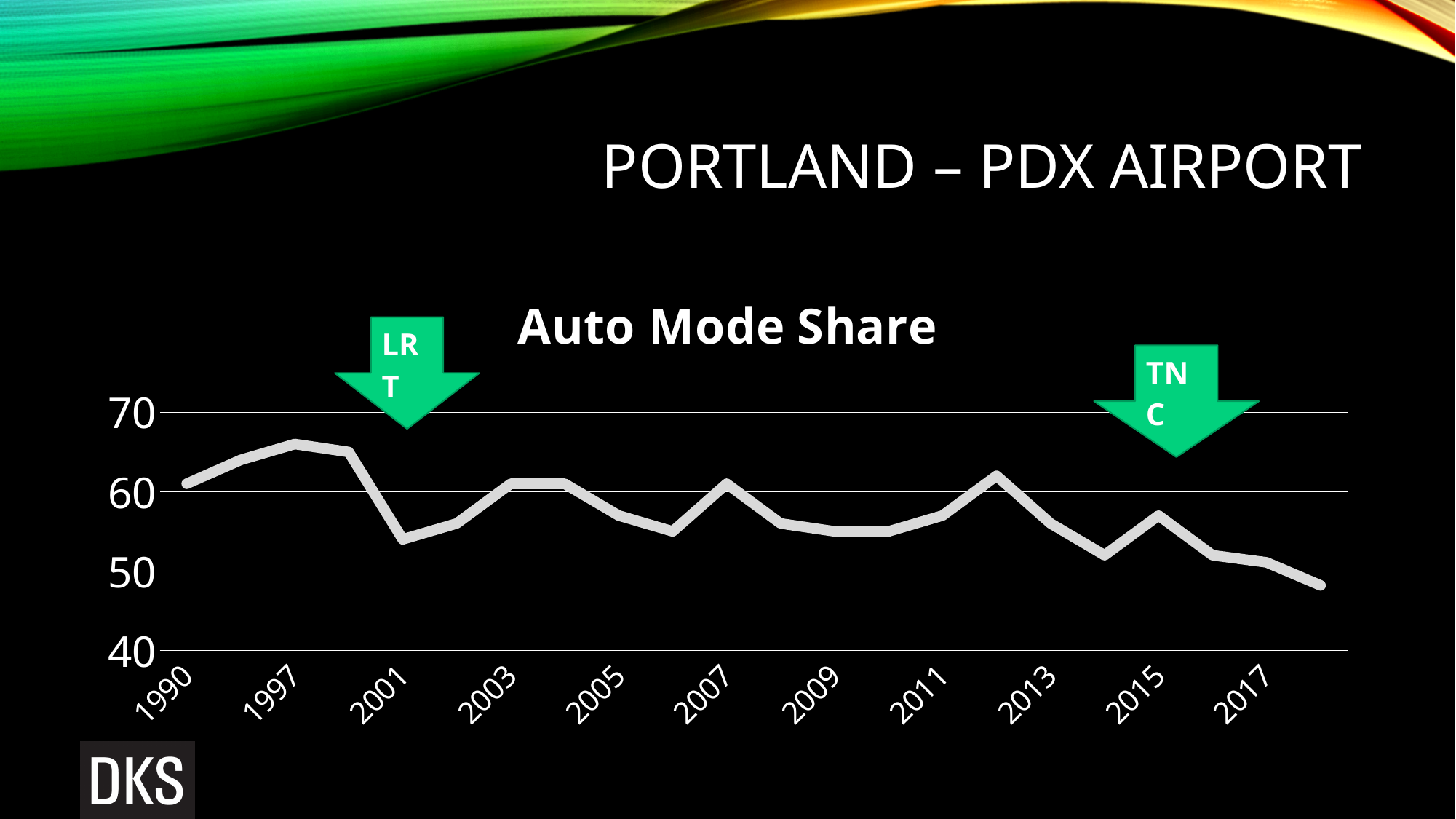
How many year labels are shown on the x axis? 11 What kind of chart is shown on the slide? line chart Is the auto mode share for 2001 greater or less than 60? less Which labelled year has the highest auto mode share? 1997 Which is larger, the auto mode share in 1997 or in 2001? 1997 Is the auto mode share for 2013 greater or less than 60? less Does the auto mode share overall rise or fall from 1990 to 2017? fall Is the auto mode share for 2009 greater or less than 60? less Which is larger, the auto mode share in 2003 or in 2009? 2003 What is the title of the chart? Auto Mode Share